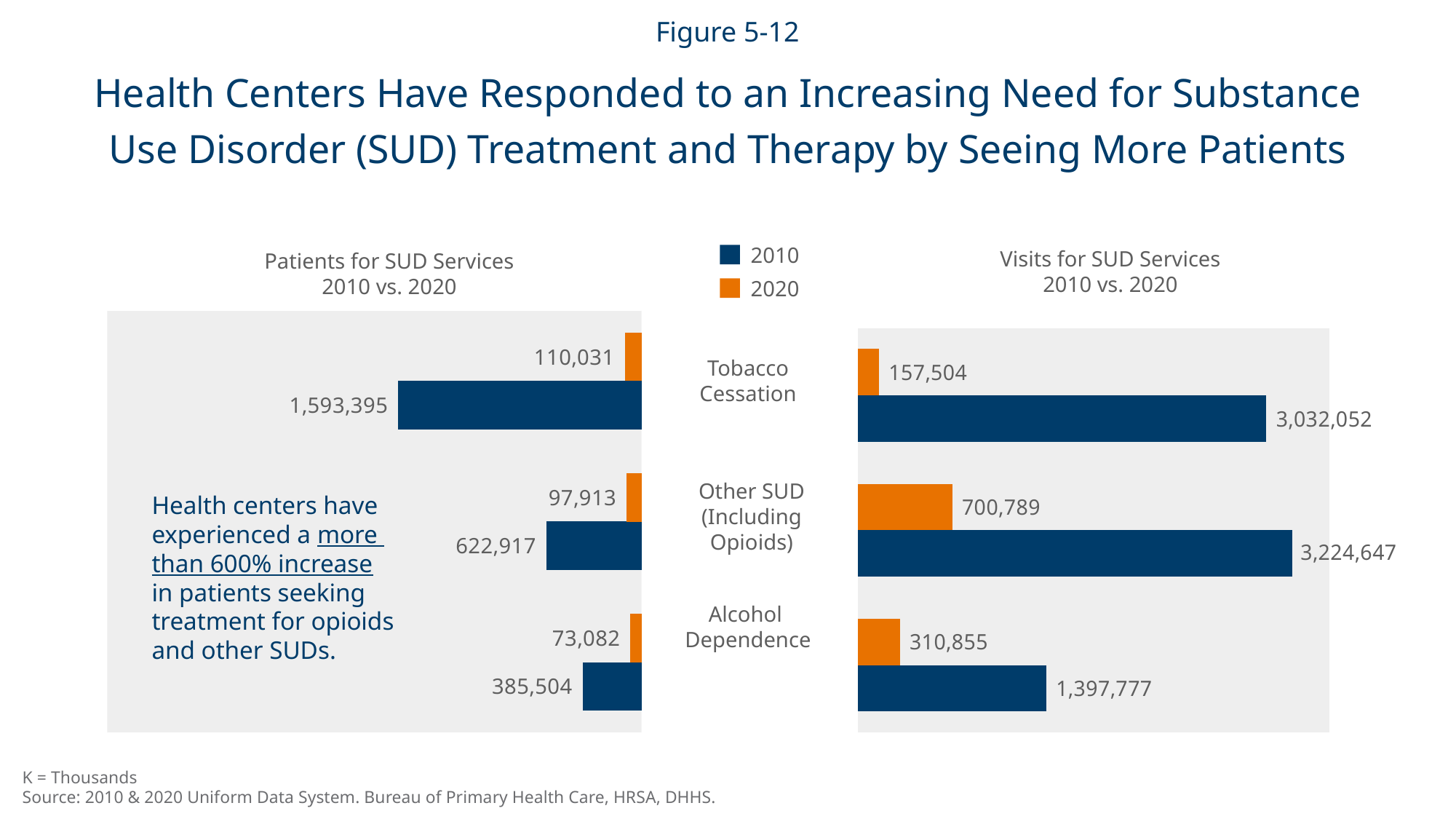
What type of chart is used on this slide? Bar chart In the Patients for SUD Services chart, what is the difference between the 2010 and 2020 values for Tobacco Cessation? 1,483,364 How many categories are shown in the Patients for SUD Services chart? 3 In the Visits for SUD Services chart, which category has the lowest 2020 value? Tobacco Cessation In the Visits for SUD Services chart, what is the 2020 value for Other SUD (Including Opioids)? 700,789 In the Visits for SUD Services chart, what is the 2010 value for Alcohol Dependence? 1,397,777 In the Visits for SUD Services chart, which category has the highest 2010 value? Other SUD (Including Opioids) In the Patients for SUD Services chart, what is the 2020 value for Alcohol Dependence? 73,082 How many series does the legend list? 2 In the Visits for SUD Services chart, what is the difference between the 2010 and 2020 values for Alcohol Dependence? 1,086,922 In the Patients for SUD Services chart, which is larger: the 2010 value for Other SUD (Including Opioids) or the 2010 value for Alcohol Dependence? Other SUD (Including Opioids) In the Patients for SUD Services chart, what is the 2010 value for Tobacco Cessation? 1,593,395